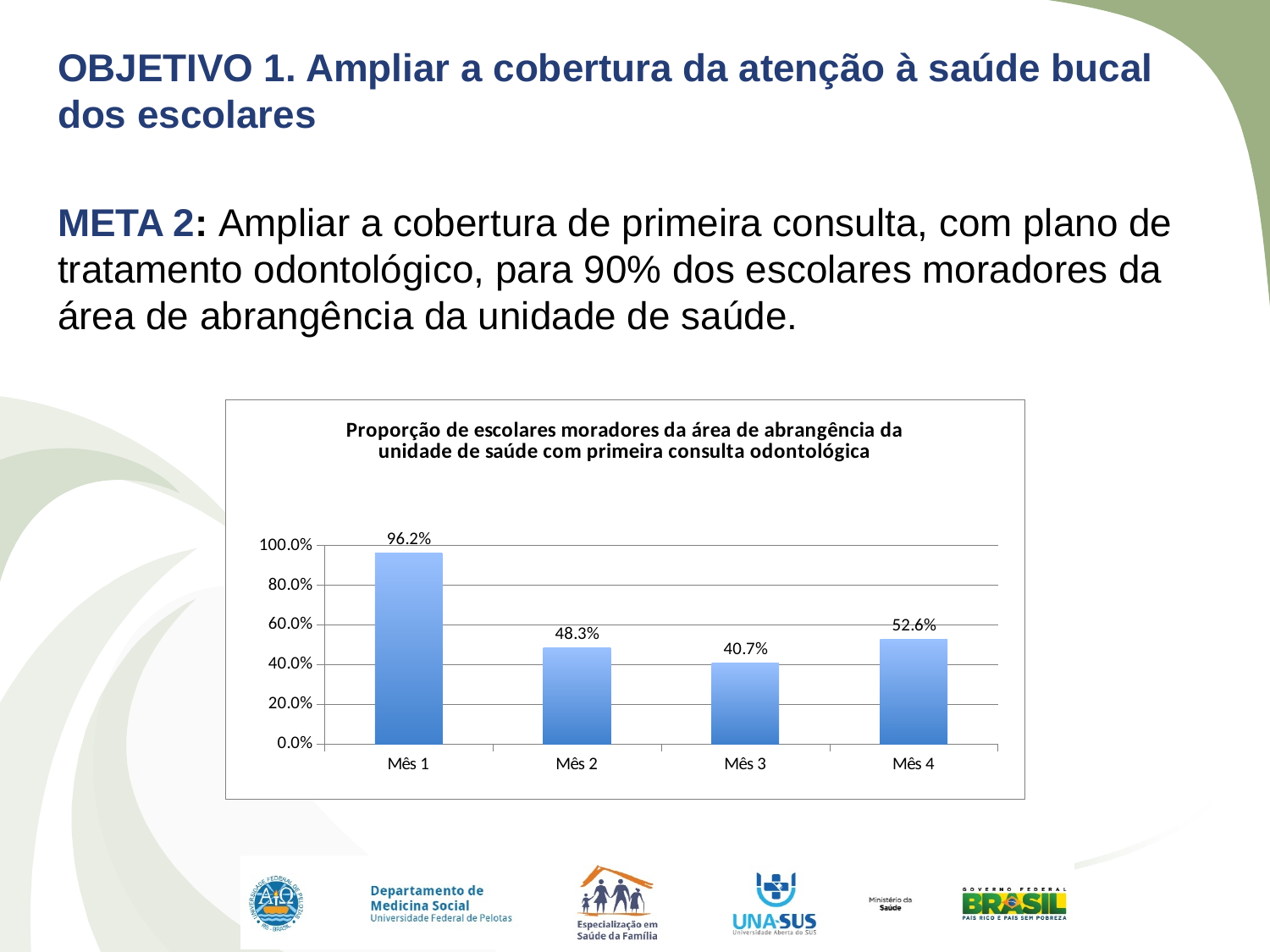
Is the value for Mês 3 greater or less than 60.0%? less What kind of chart is shown on the slide? bar chart What is the value for Mês 4? 52.6% What is the value for Mês 3? 40.7% What is the value for Mês 1? 96.2% Which month has the lowest proportion? Mês 3 Which month has the highest proportion? Mês 1 Do the values rise or fall from Mês 1 to Mês 2? fall How many months are shown on the x axis? 4 What is the difference between the values for Mês 1 and Mês 2? 47.9% What is the title of the chart? Proporção de escolares moradores da área de abrangência da unidade de saúde com primeira consulta odontológica Which is larger, the value for Mês 2 or the value for Mês 4? Mês 4